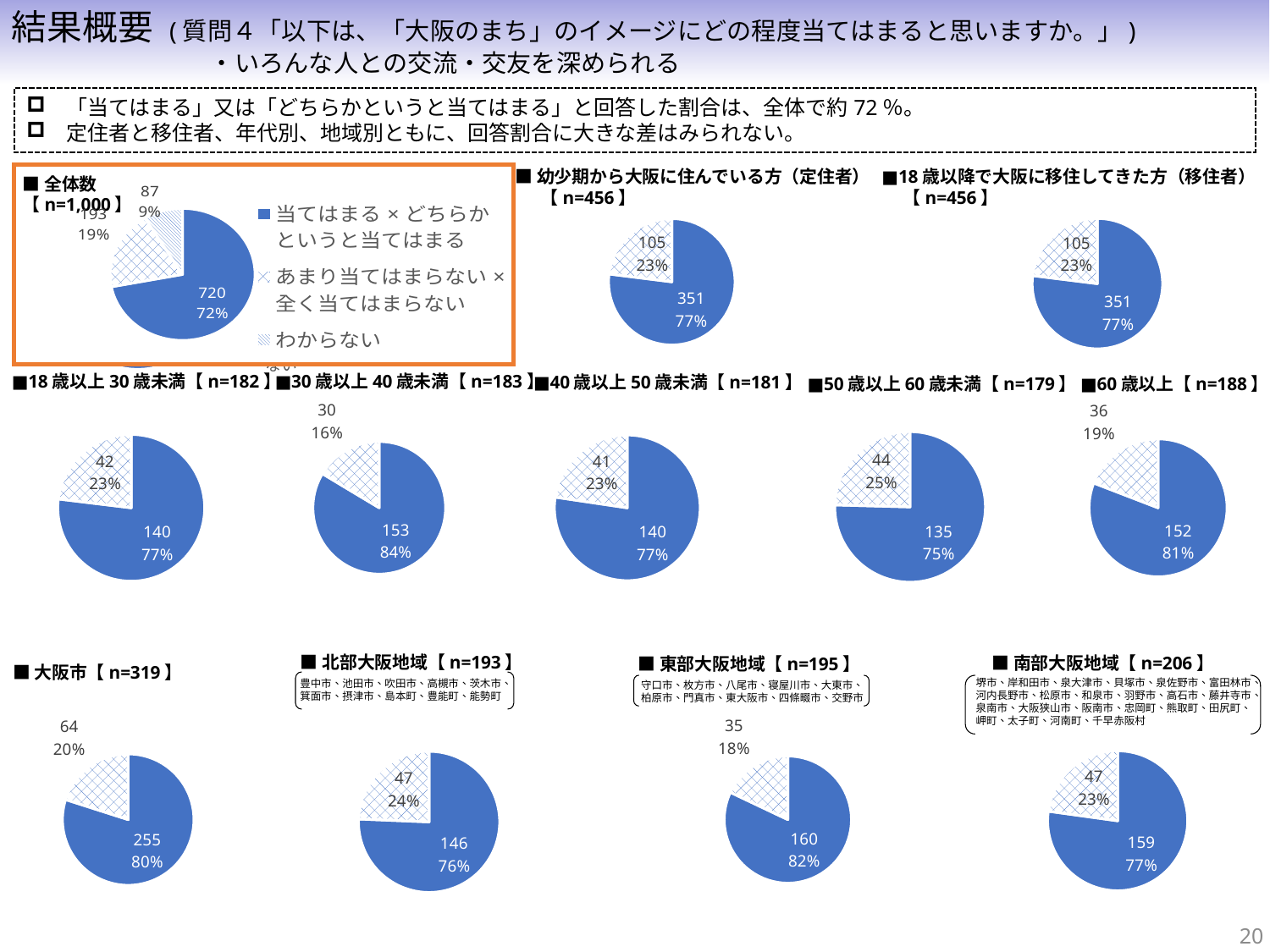
年代別の5つの円グラフのうち、大きい方の区分の割合が最も低いのはどの年代ですか。 50歳以上60歳未満 「南部大阪地域【n=206】」の円グラフで、小さい方の区分の割合は何%ですか。 23% このスライドに使われているグラフの種類は何ですか。 円グラフ 「全体数【n=1,000】」の円グラフで、「わからない」の割合は何%ですか。 9% 「東部大阪地域【n=195】」の円グラフと「北部大阪地域【n=193】」の円グラフでは、大きい方の区分の割合はどちらが高いですか。 東部大阪地域 「30歳以上40歳未満【n=183】」の円グラフで、小さい方の区分の回答数はいくつですか。 30 「幼少期から大阪に住んでいる方（定住者）【n=456】」の円グラフで、大きい方の区分の割合は何%ですか。 77% 「全体数【n=1,000】」の円グラフの凡例には、いくつの項目がありますか。 3 「全体数【n=1,000】」の円グラフで、「当てはまる×どちらかというと当てはまる」の回答数はいくつですか。 720 「全体数【n=1,000】」の円グラフで、「あまり当てはまらない×全く当てはまらない」の回答数と「わからない」の回答数の差はいくつですか。 106 「大阪市【n=319】」の円グラフで、大きい方の区分の回答数はいくつですか。 255 年代別の5つの円グラフのうち、大きい方の区分の割合が最も高いのはどの年代ですか。 30歳以上40歳未満